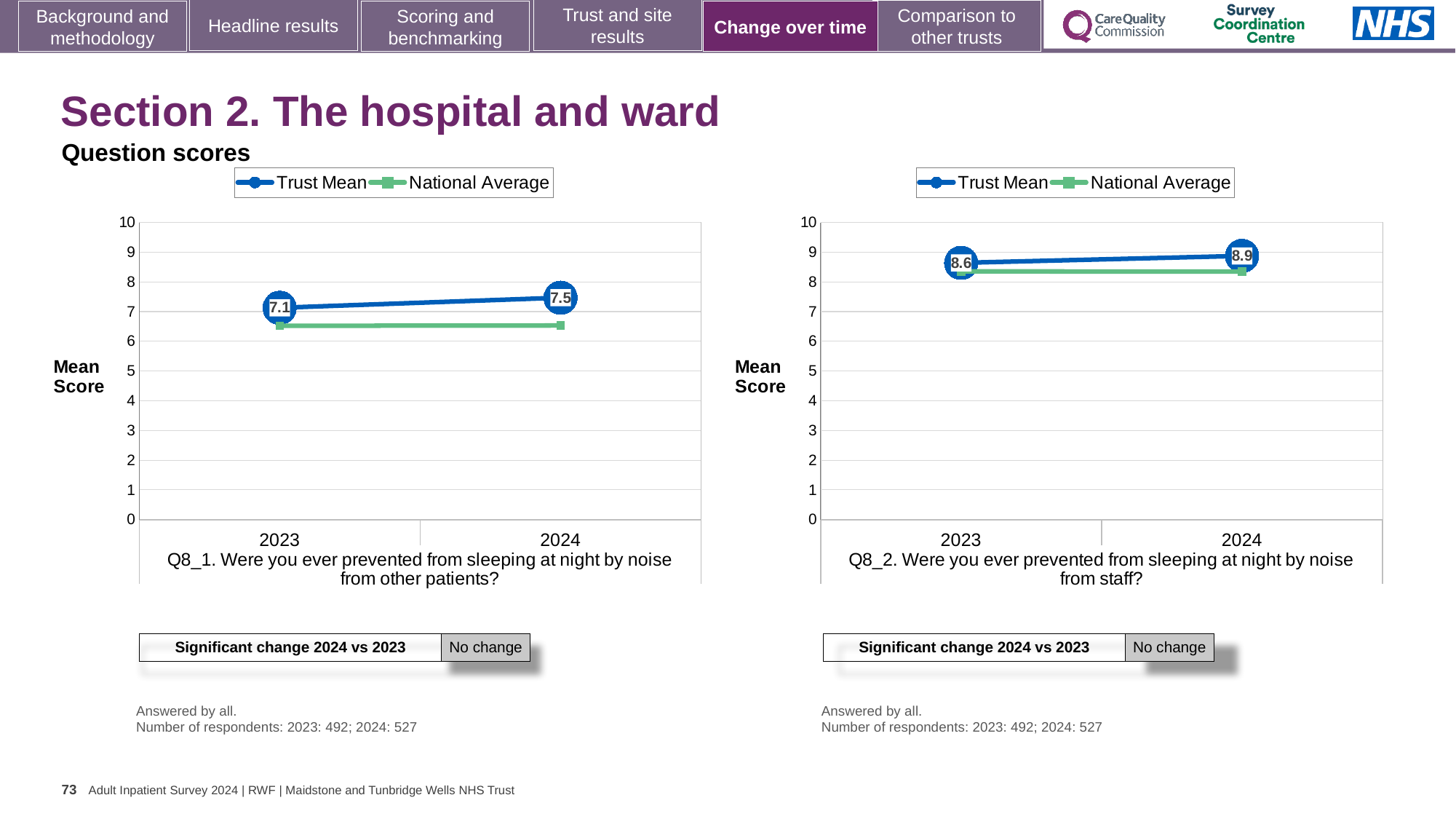
In the Q8_1 chart (left), what is the Trust Mean score for 2023? 7.1 In the Q8_1 chart (left), does the Trust Mean rise or fall from 2023 to 2024? rise In the Q8_1 chart (left), is the National Average for 2024 greater or less than 7? less In the Q8_2 chart (right), what is the Trust Mean score for 2024? 8.9 In the Q8_2 chart (right), which year has the higher Trust Mean, 2023 or 2024? 2024 How many series does the legend of the Q8_1 chart (left) list? 2 In the Q8_2 chart (right), what is the difference between the Trust Mean in 2024 and 2023? 0.3 In the Q8_1 chart (left), what is the Trust Mean score for 2024? 7.5 In the Q8_1 chart (left), by how much did the Trust Mean change from 2023 to 2024? 0.4 What kind of chart is the Q8_2 chart (right)? line chart In the Q8_2 chart (right), what is the Trust Mean score for 2023? 8.6 In the Q8_2 chart (right), is the National Average for 2023 greater or less than 8? greater